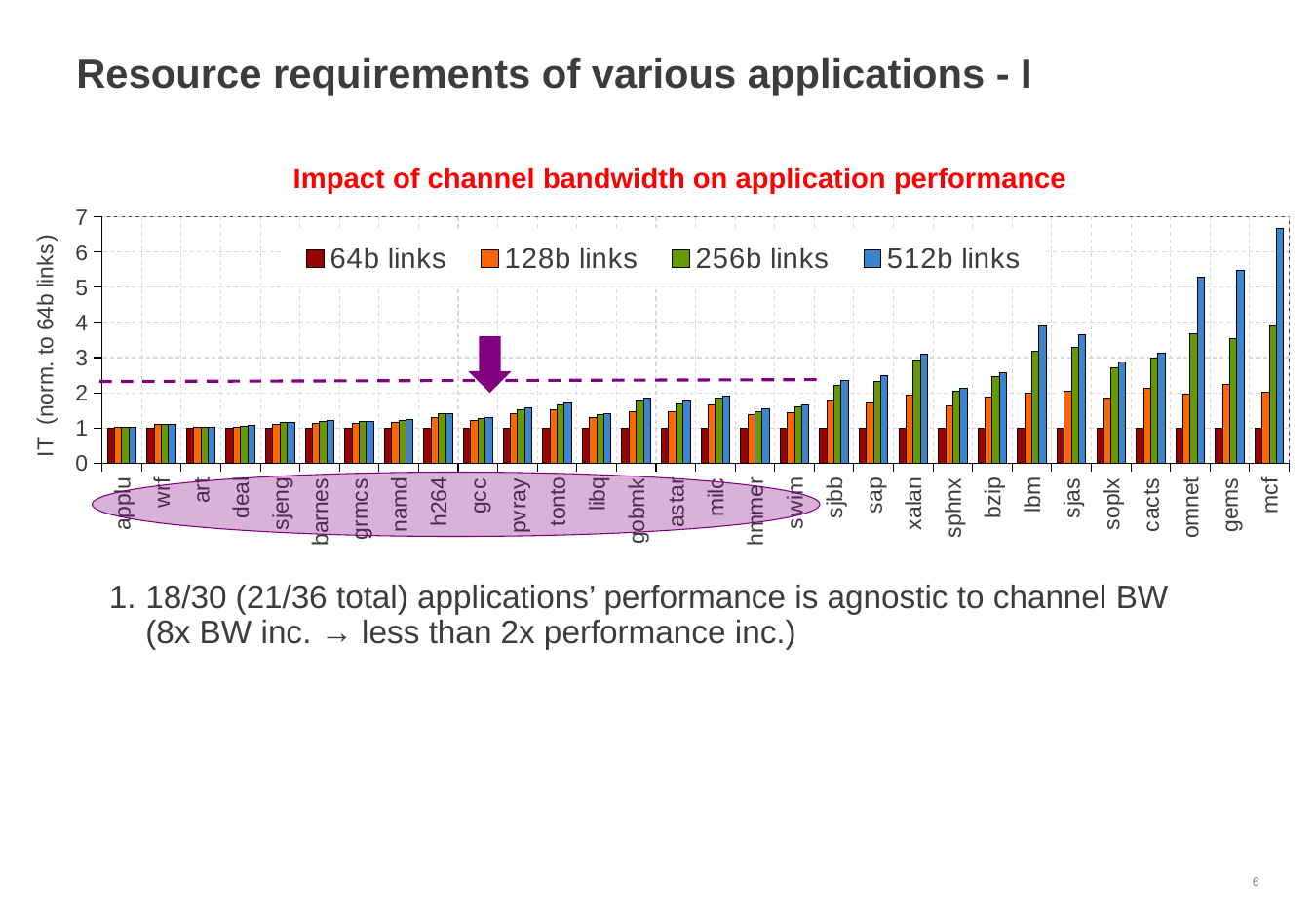
How many applications (categories) are plotted along the x axis? 30 Is the 512b links value for mcf greater or less than 6? greater How many series does the chart's legend list? 4 What kind of chart is shown on the slide? bar chart Which application has the highest value for 512b links? mcf What is the title of the chart? Impact of channel bandwidth on application performance Do the 512b links values generally rise or fall moving from left to right along the x axis? rise Which is larger, the 512b links value for gems or the 512b links value for sjas? gems What is the label of the y axis? IT (norm. to 64b links) Is the 512b links value for omnet greater or less than 5? greater Is the 512b links value for applu greater or less than 2? less